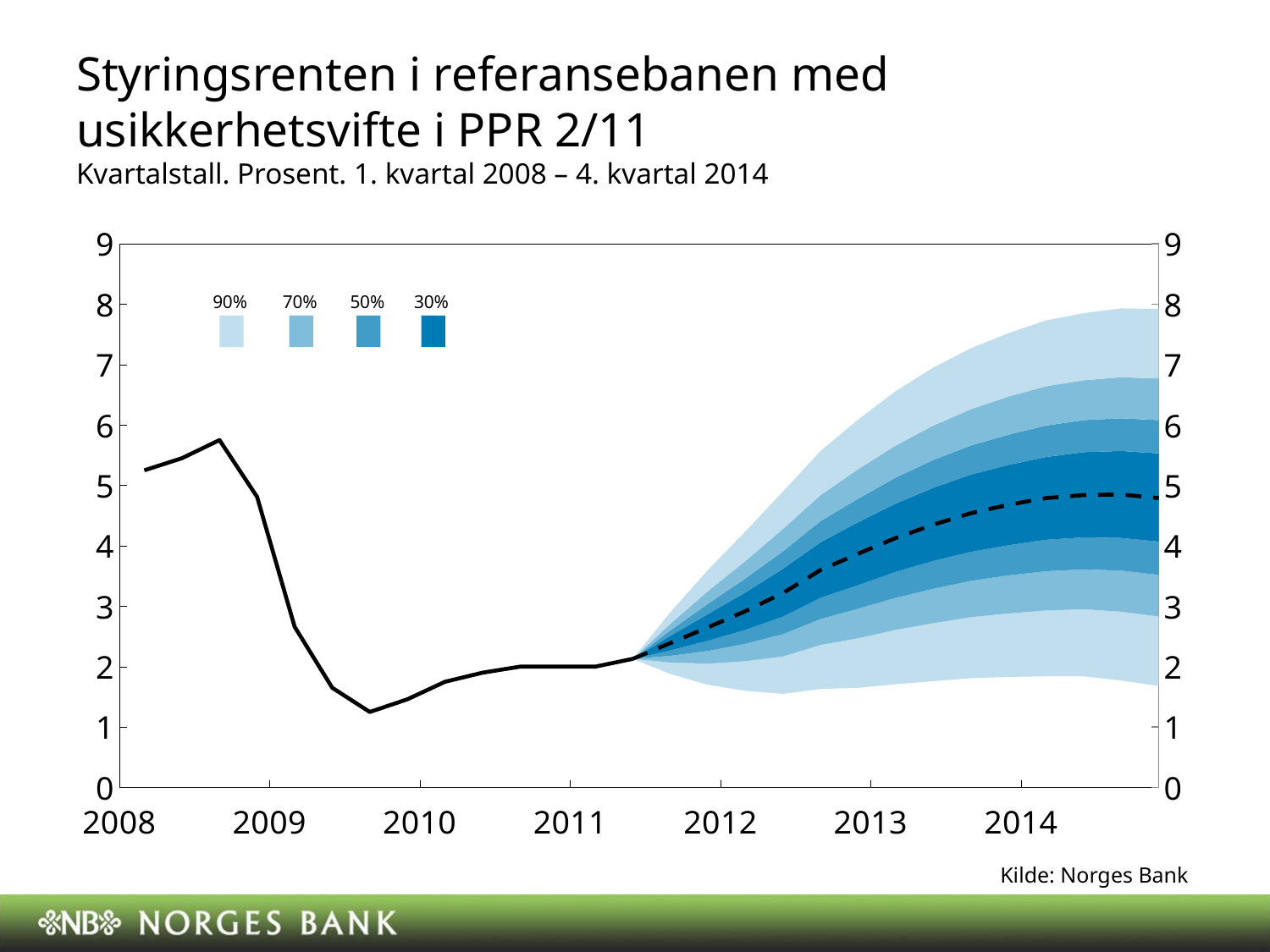
In which year does the solid policy rate line reach its highest value? 2008 What kind of chart is shown on the slide? combination line and area chart (a line with shaded uncertainty bands, i.e. a fan chart) Is the peak of the policy rate in 2008 greater or less than 5? greater Does the dashed projected rate rise or fall from 2011 to 2014? rise Is the upper edge of the 90% band at the end of 2014 greater or less than 7? greater Is the policy rate at the start of 2008 greater or less than 4? greater How many probability bands does the legend list for the uncertainty fan? 4 Does the policy rate rise or fall between the peak in 2008 and the end of 2009? fall Which probability bands are listed in the legend? 90%, 70%, 50%, 30% What is the highest value shown on the y axis? 9